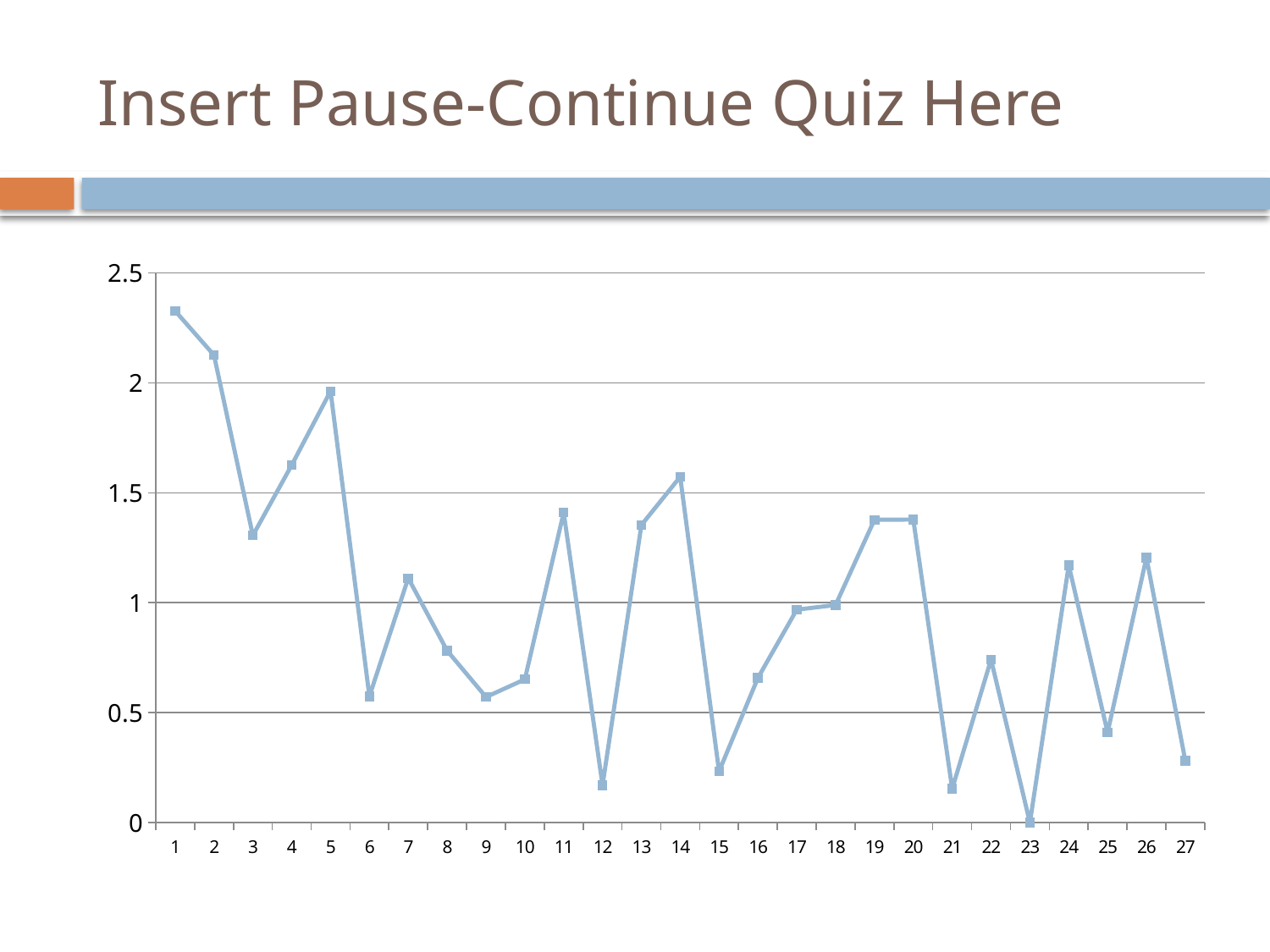
Is the value at category 6 greater or less than 1? less How many points are plotted along the x axis? 27 Is the value at category 12 greater or less than 0.5? less Overall, do the values rise or fall from category 1 to category 27? fall Which x-axis category has the lowest value? 23 Is the value at category 1 greater or less than 2? greater What kind of chart is shown on the slide? line chart Which is larger, the value at category 21 or the value at category 22? 22 Which x-axis category has the highest value? 1 Which is larger, the value at category 5 or the value at category 6? 5 What is the value at category 23? 0